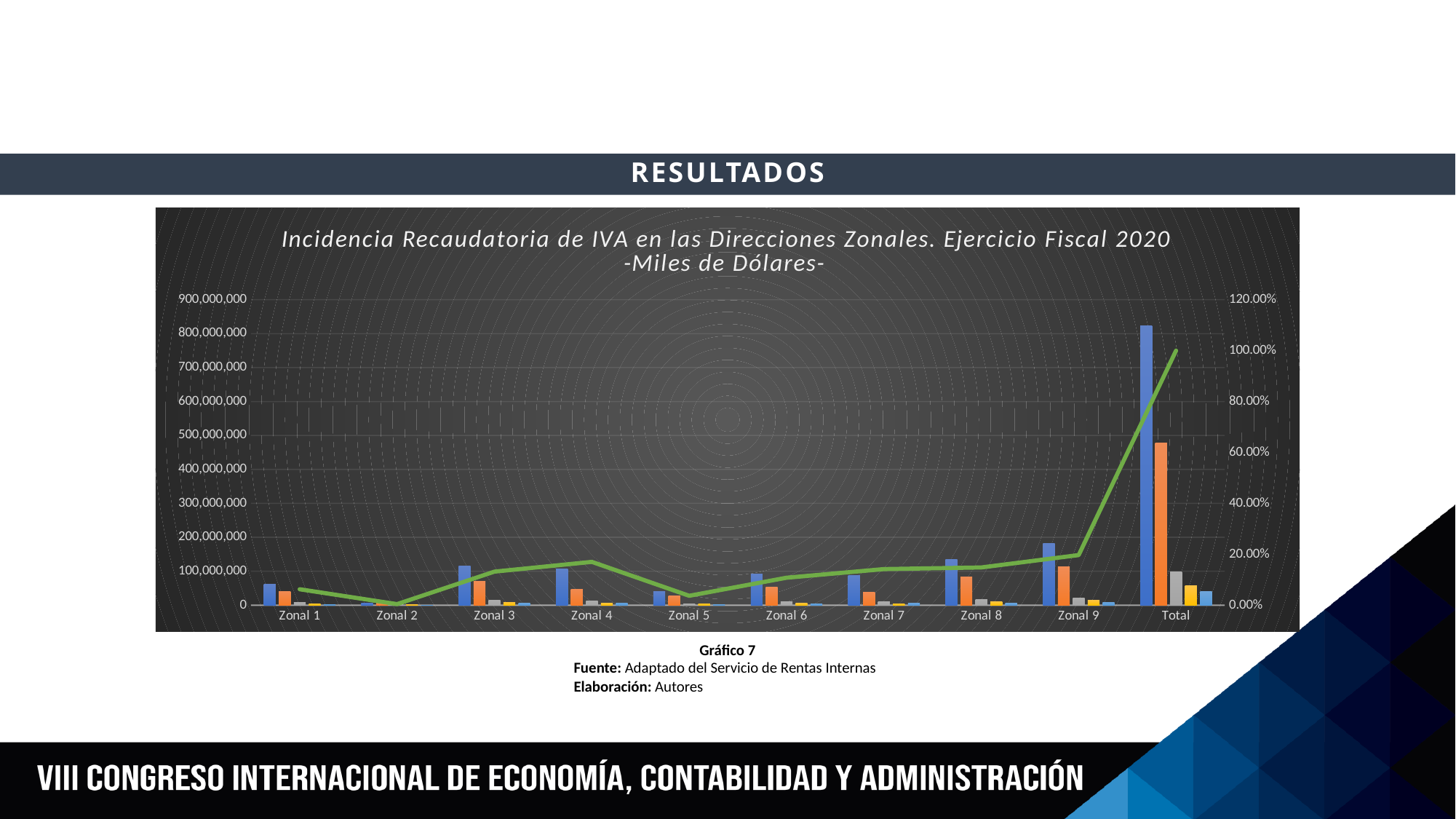
Is the blue bar for Zonal 9 greater or less than 100,000,000? greater What kind of chart is shown on the slide? Combined bar and line chart Which category has the tallest blue bar in the chart? Total How many categories are shown on the x axis of the chart? 10 Is the orange bar for Total greater or less than 400,000,000? greater Among Zonal 1 to Zonal 9, which category has the tallest blue bar? Zonal 9 What is the title of the chart? Incidencia Recaudatoria de IVA en las Direcciones Zonales. Ejercicio Fiscal 2020 -Miles de Dólares- Is the blue bar for Total greater or less than 700,000,000? greater Which has the taller blue bar, Zonal 3 or Zonal 5? Zonal 3 Among Zonal 1 to Zonal 9, which category has the shortest blue bar? Zonal 2 Does the green line rise or fall between Zonal 9 and Total? rise